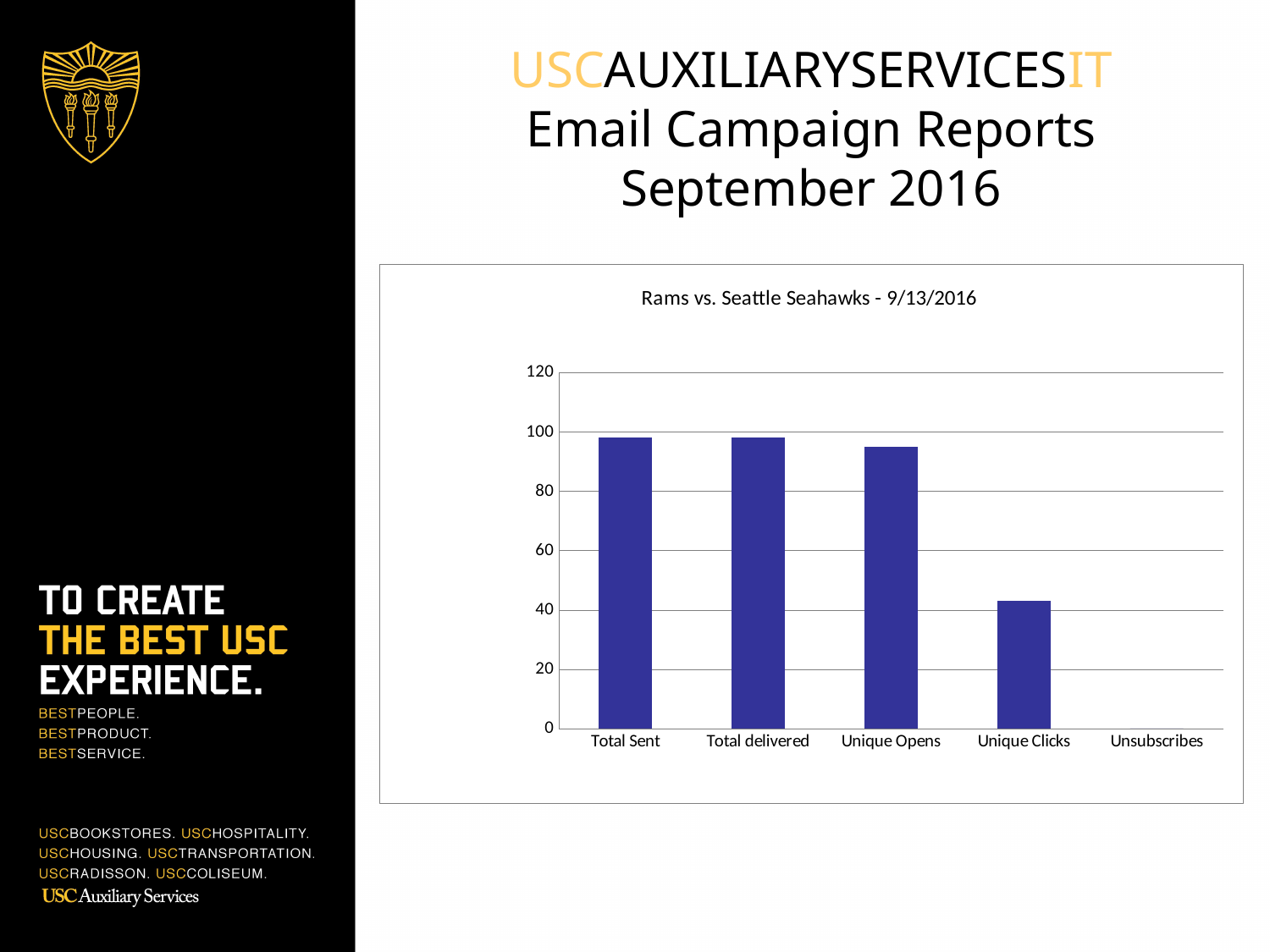
Which category has the lowest value in the chart? Unsubscribes What is the title of the chart? Rams vs. Seattle Seahawks - 9/13/2016 Is the value for Total Sent greater or less than 80? greater Is the value for Unique Opens greater or less than 100? less Is the value for Unique Clicks greater or less than 60? less Which is larger, the value for Unique Opens or the value for Unique Clicks? Unique Opens Which is larger, the value for Unique Clicks or the value for Unsubscribes? Unique Clicks Do the values generally rise or fall moving from left to right along the x axis? fall What kind of chart is shown on the slide? bar chart What is the highest value shown on the y axis of the chart? 120 How many categories are shown on the x axis of the chart? 5